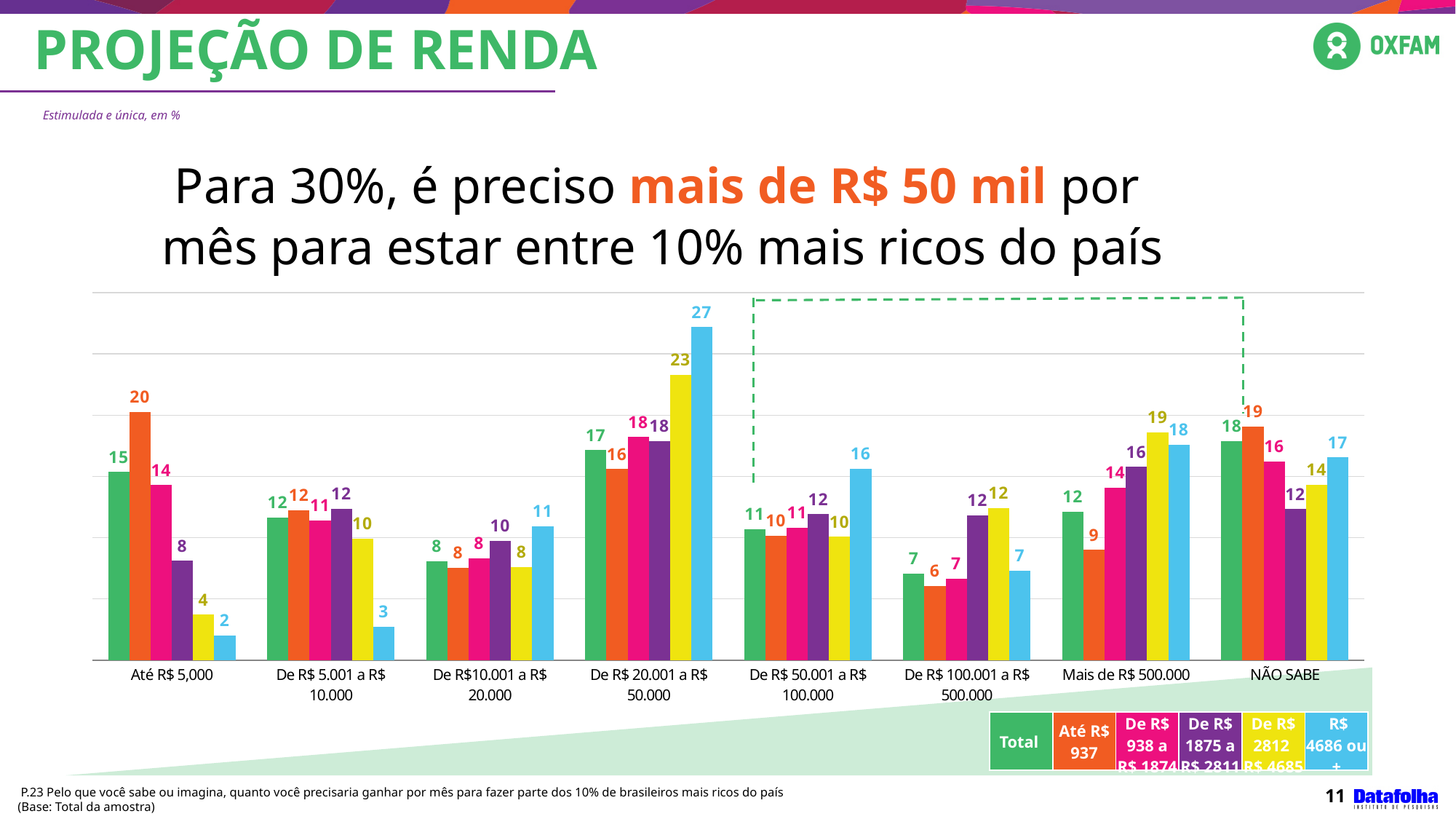
What is the value for the 'De R$ 2812 a R$ 4685' series in the category 'Mais de R$ 500.000'? 19 What is the value for the 'Até R$ 937' series in the category 'Até R$ 5,000'? 20 Which category has the highest value for the 'R$ 4686 ou +' series? De R$ 20.001 a R$ 50.000 How many income categories are shown on the x axis of the chart? 8 What is the difference between the 'R$ 4686 ou +' value and the 'Até R$ 937' value in the category 'Até R$ 5,000'? 18 What is the Total value for the category 'De R$ 20.001 a R$ 50.000'? 17 Which category has the lowest value for the 'Até R$ 937' series? De R$ 100.001 a R$ 500.000 What colour represents the 'Total' series in the chart? Green In the category 'NÃO SABE', which is larger: the Total value or the 'De R$ 1875 a R$ 2811' value? Total What is the value for the 'R$ 4686 ou +' series in the category 'De R$ 20.001 a R$ 50.000'? 27 What kind of chart is shown on the slide? Bar chart How many series does the chart legend list? 6